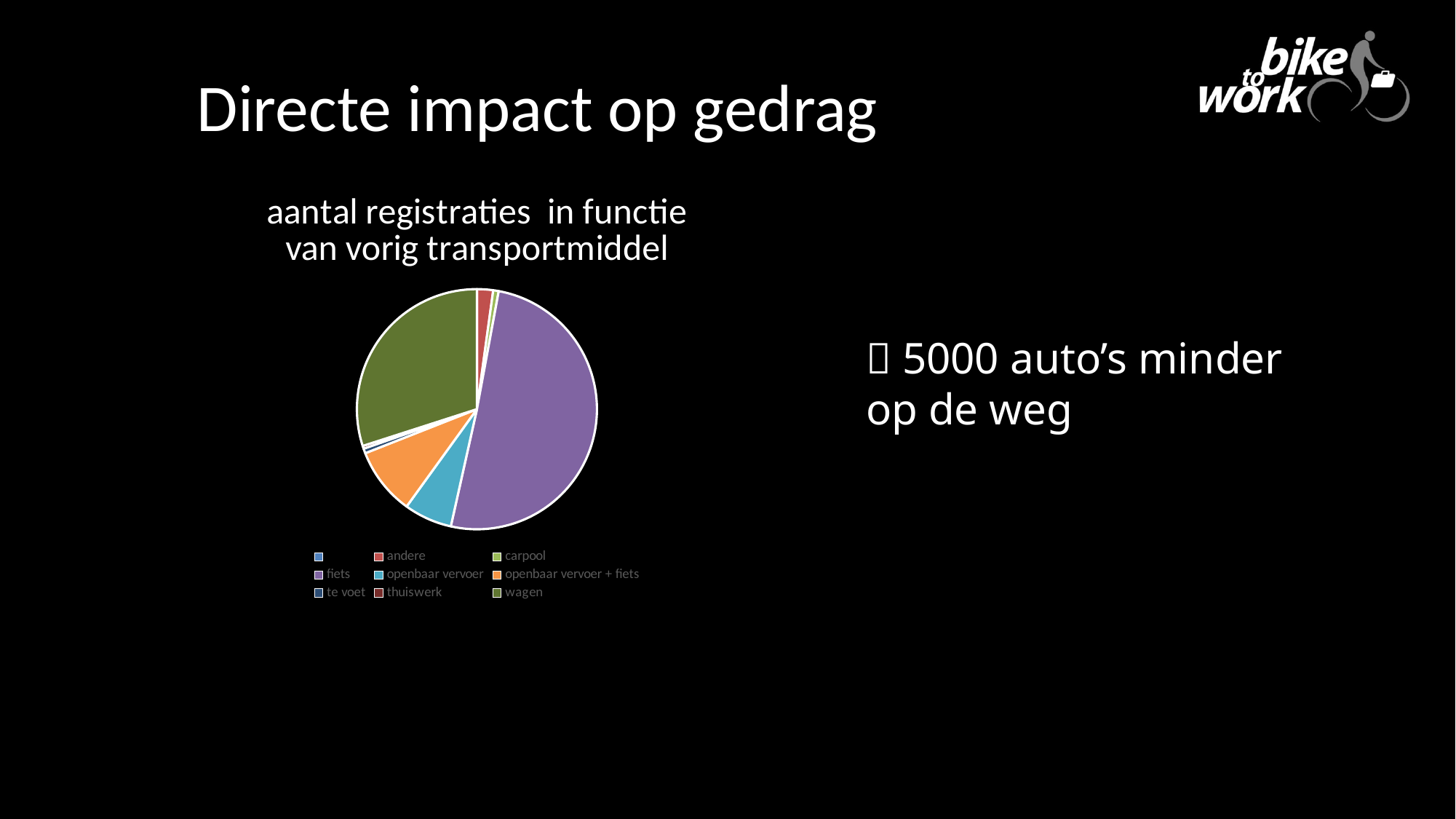
Which slice is larger, fiets or wagen? fiets What colour is the fiets slice in the pie chart? purple What is the title of the pie chart? aantal registraties in functie van vorig transportmiddel Which slice is larger, wagen or openbaar vervoer? wagen Which slice is larger, wagen or openbaar vervoer + fiets? wagen Which category has the largest slice in the pie chart? fiets What kind of chart is shown on the slide? pie chart